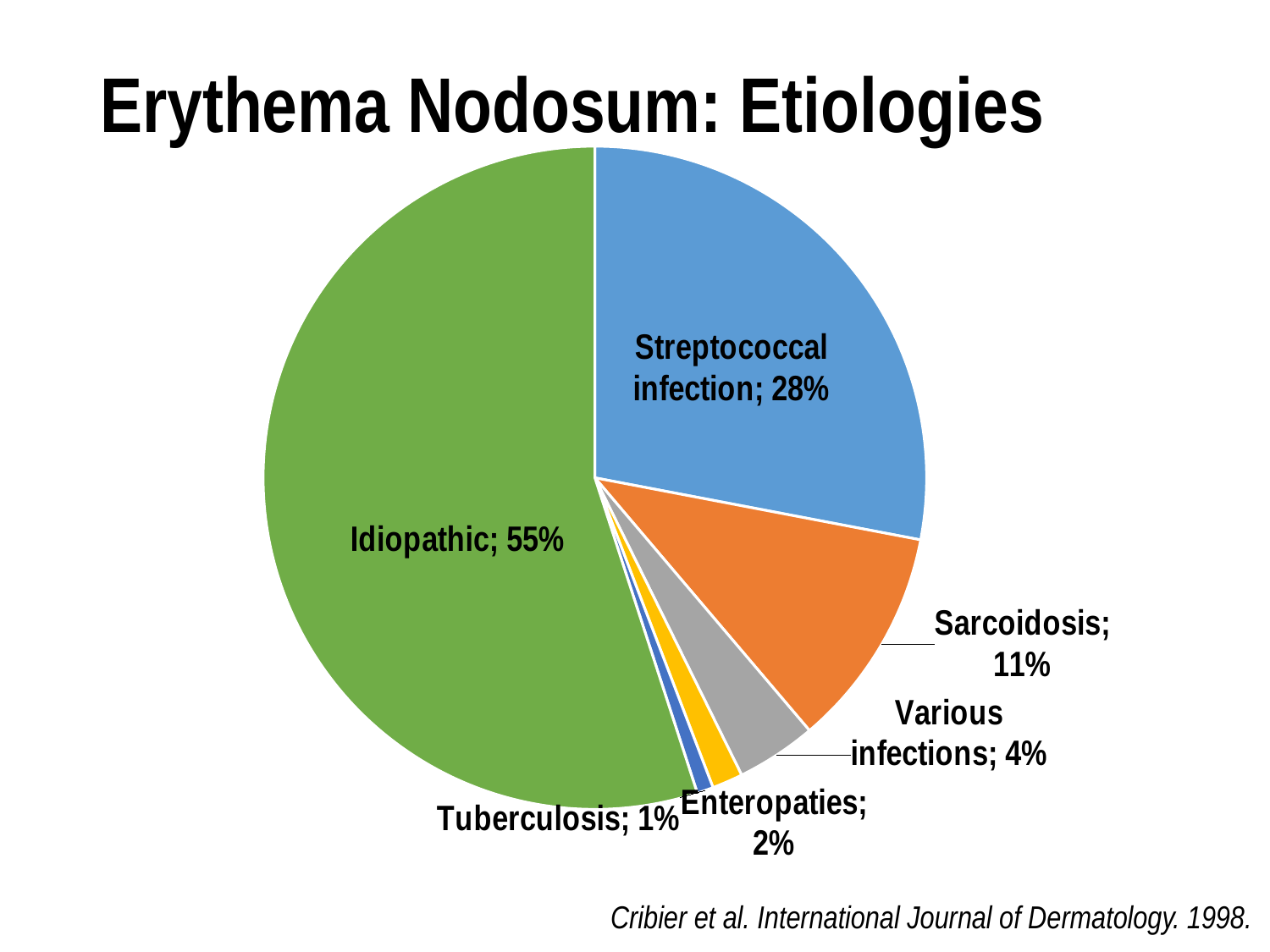
What is the difference in percentage points between Idiopathic and Streptococcal infection? 27% Which etiology has the smallest share of the pie? Tuberculosis What type of chart is shown on the slide? Pie chart What percentage of erythema nodosum cases are attributed to Idiopathic causes? 55% Which etiology has the largest share of the pie? Idiopathic Which is larger, the share for Sarcoidosis or the share for Various infections? Sarcoidosis What is the value for Various infections? 4% What is the value shown for Streptococcal infection? 28% What percentage is shown for Enteropaties? 2% What percentage is shown for Sarcoidosis? 11% How many etiology categories are shown in the pie chart? 6 What is the title of the slide containing the chart? Erythema Nodosum: Etiologies